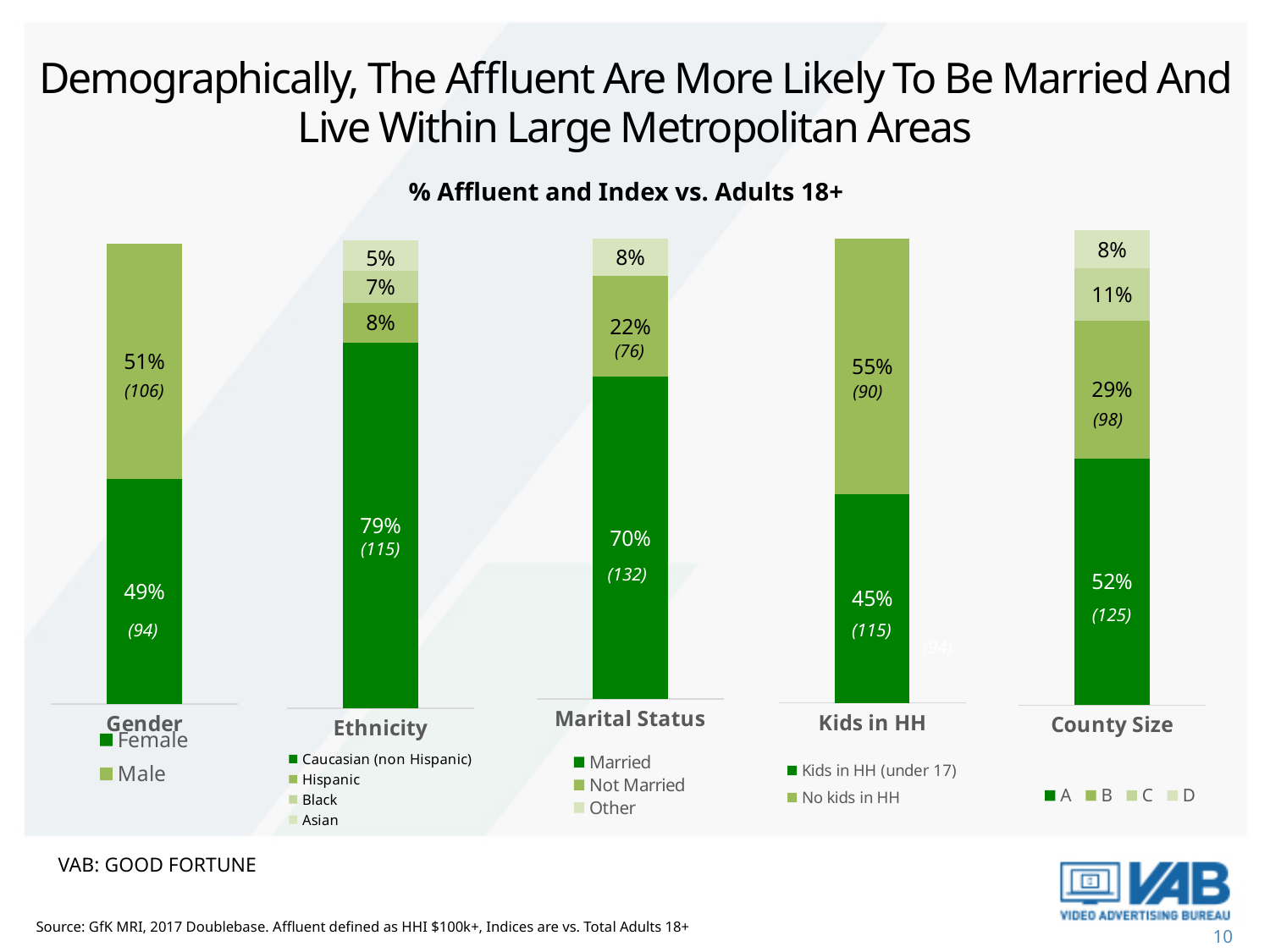
In the Gender chart, what is the index shown for Male? 106 What kind of chart is used for the Marital Status data? Stacked bar chart In the County Size chart, what is the total of all four segments of the stacked bar? 100% In the Marital Status chart, what is the index shown for Married? 132 In the Kids in HH chart, which is larger: Kids in HH (under 17) or No kids in HH? No kids in HH In the Marital Status chart, what is the difference in percentage points between Married and Not Married? 48 percentage points In the Gender chart, what percentage of the affluent are Female? 49% How many series does the legend of the County Size chart list? 4 In the Ethnicity chart, which segment has the smallest percentage? Asian In the County Size chart, what percentage is shown for county size B? 29% How many series does the legend of the Ethnicity chart list? 4 In the Ethnicity chart, what percentage is shown for Caucasian (non Hispanic)? 79%